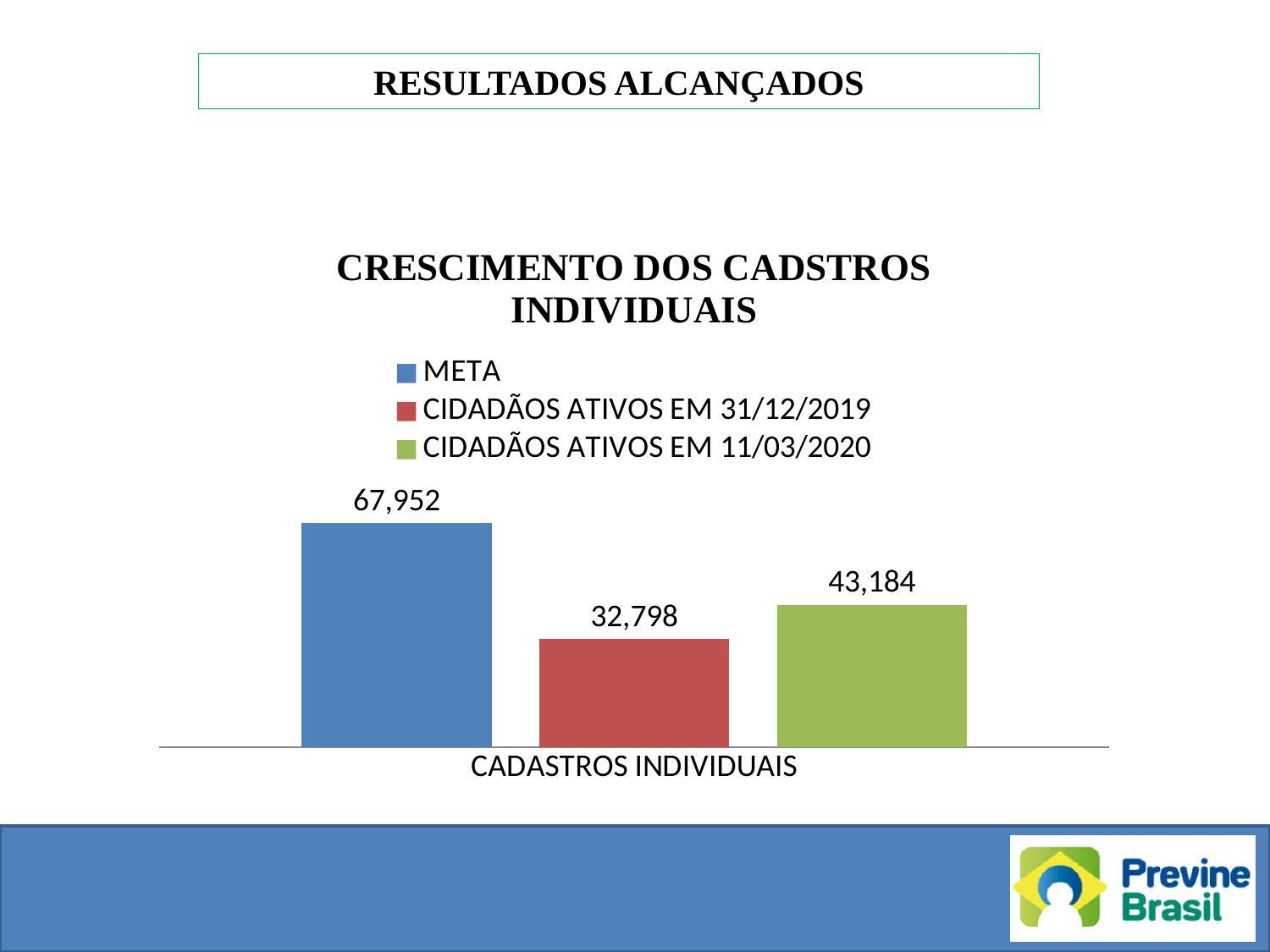
Which series has the highest value? META What is the value of META in the chart? 67,952 What is the title of the chart? CRESCIMENTO DOS CADSTROS INDIVIDUAIS How many series does the legend list? 3 What is the difference between META and CIDADÃOS ATIVOS EM 11/03/2020? 24,768 Which is larger: CIDADÃOS ATIVOS EM 31/12/2019 or CIDADÃOS ATIVOS EM 11/03/2020? CIDADÃOS ATIVOS EM 11/03/2020 What kind of chart is shown on the slide? Bar chart What is the value for CIDADÃOS ATIVOS EM 31/12/2019? 32,798 What is the category label shown on the x axis? CADASTROS INDIVIDUAIS By how much did the number of active citizens grow from 31/12/2019 to 11/03/2020? 10,386 What is the value for CIDADÃOS ATIVOS EM 11/03/2020? 43,184 Which series has the lowest value? CIDADÃOS ATIVOS EM 31/12/2019